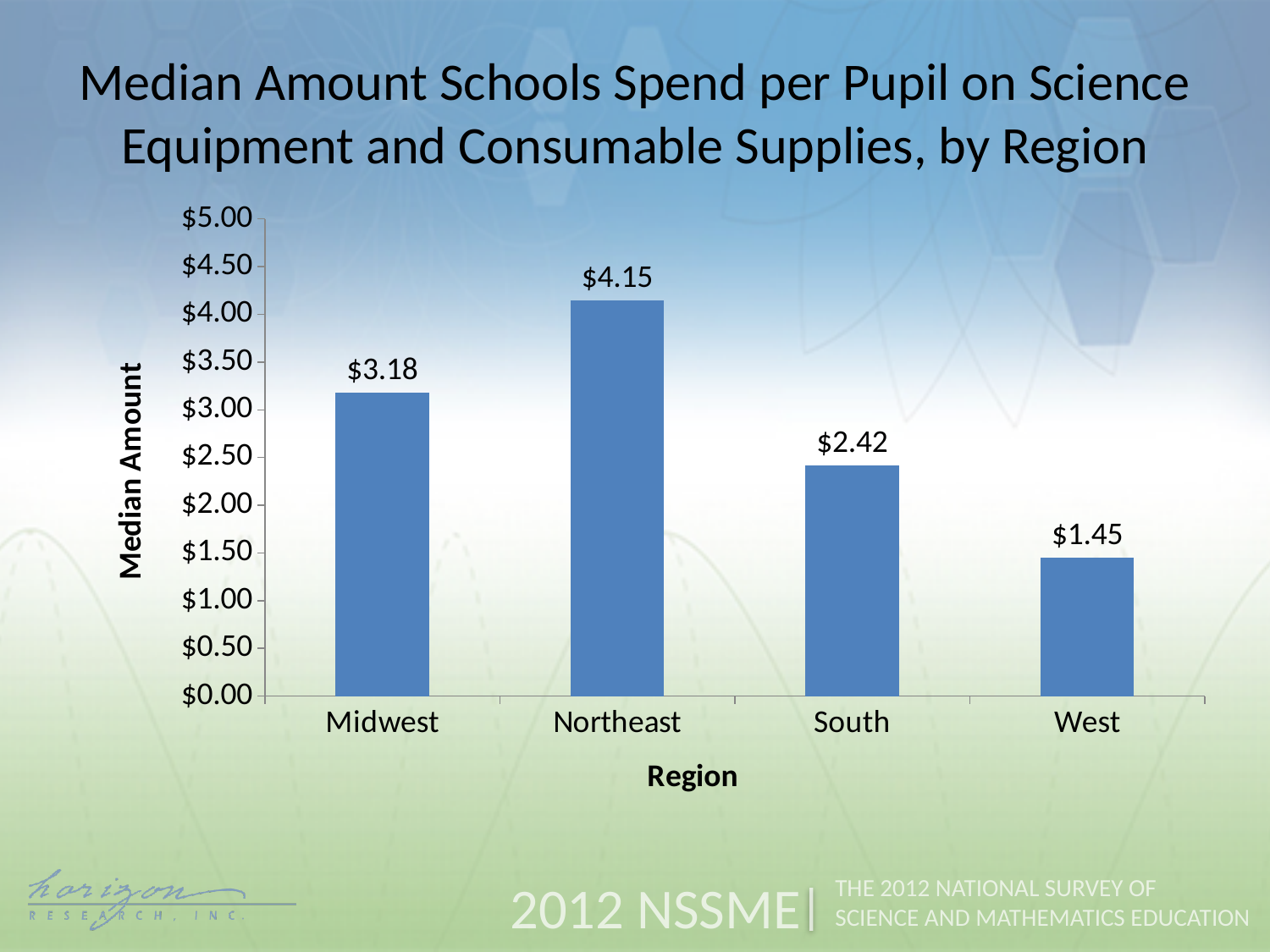
What is the median amount spent per pupil in the Midwest? $3.18 What is the median amount spent per pupil in the Northeast? $4.15 Which region has a larger median amount, the Midwest or the South? Midwest Which region has the highest median amount spent per pupil? Northeast What kind of chart is shown on the slide? Bar chart What is the difference between the median amounts for the Northeast and the West? $2.70 Is the value for the South greater or less than $3.00? less What is the median amount spent per pupil in the West? $1.45 Which region has the lowest median amount spent per pupil? West What is the difference between the median amounts for the Midwest and the South? $0.76 How many regions are shown on the chart? 4 What is the median amount spent per pupil in the South? $2.42